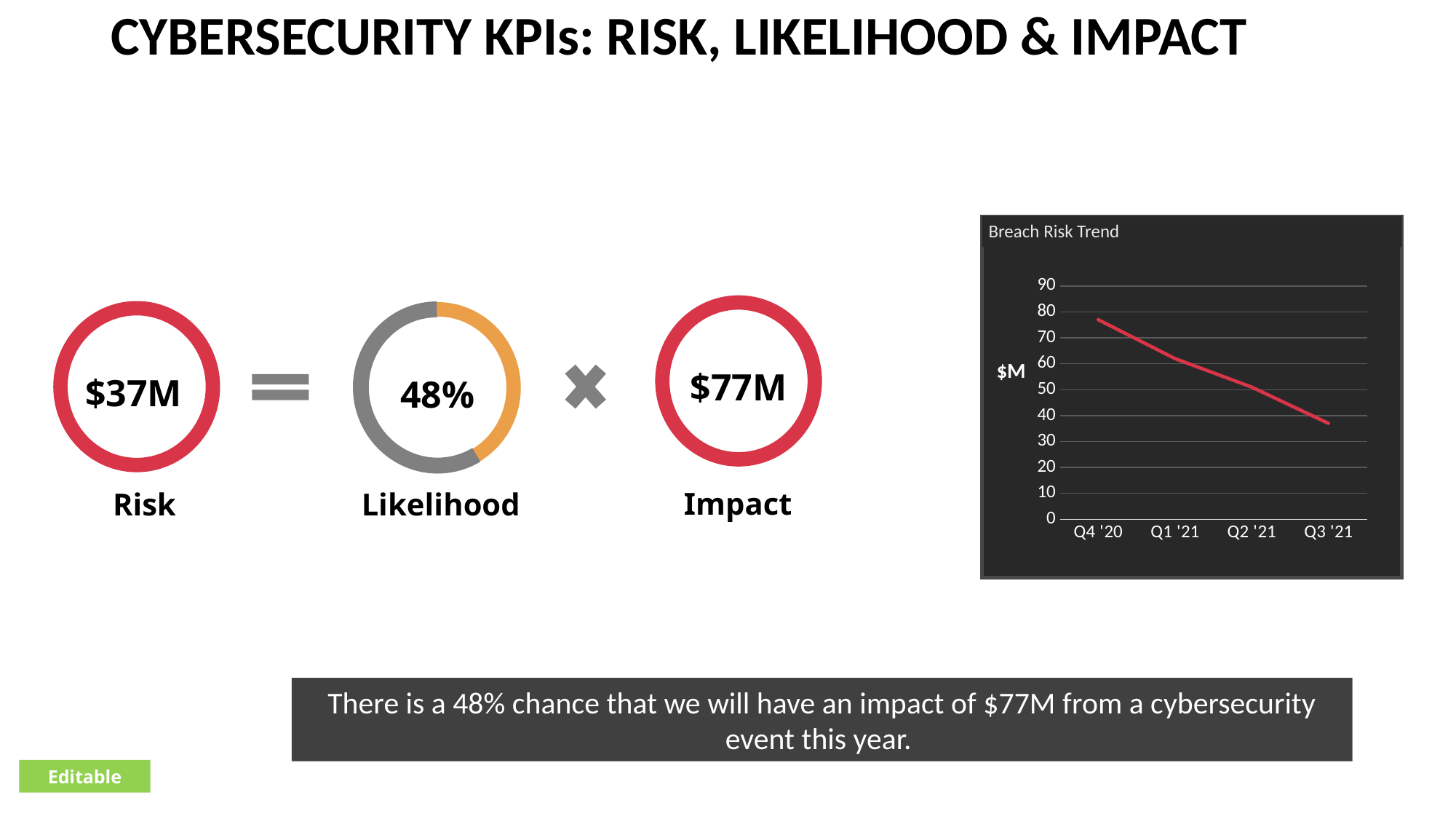
In the Breach Risk Trend chart, is the value for Q3 '21 greater or less than 40? less In the Breach Risk Trend chart, is the value for Q1 '21 greater or less than 70? less What is the title of the line chart on the right of the slide? Breach Risk Trend What value is shown in the centre of the Likelihood donut chart? 48% What kind of chart is the Breach Risk Trend chart? line chart In the Breach Risk Trend chart, is the value for Q4 '20 greater or less than 70? greater In the Breach Risk Trend chart, which is larger, the value for Q1 '21 or the value for Q2 '21? Q1 '21 In the Breach Risk Trend chart, do the values rise or fall from Q4 '20 to Q3 '21? fall What is the label on the y axis of the Breach Risk Trend chart? $M In the Breach Risk Trend chart, which quarter has the lowest value? Q3 '21 How many quarters are plotted on the x axis of the Breach Risk Trend chart? 4 In the Breach Risk Trend chart, which quarter has the highest value? Q4 '20